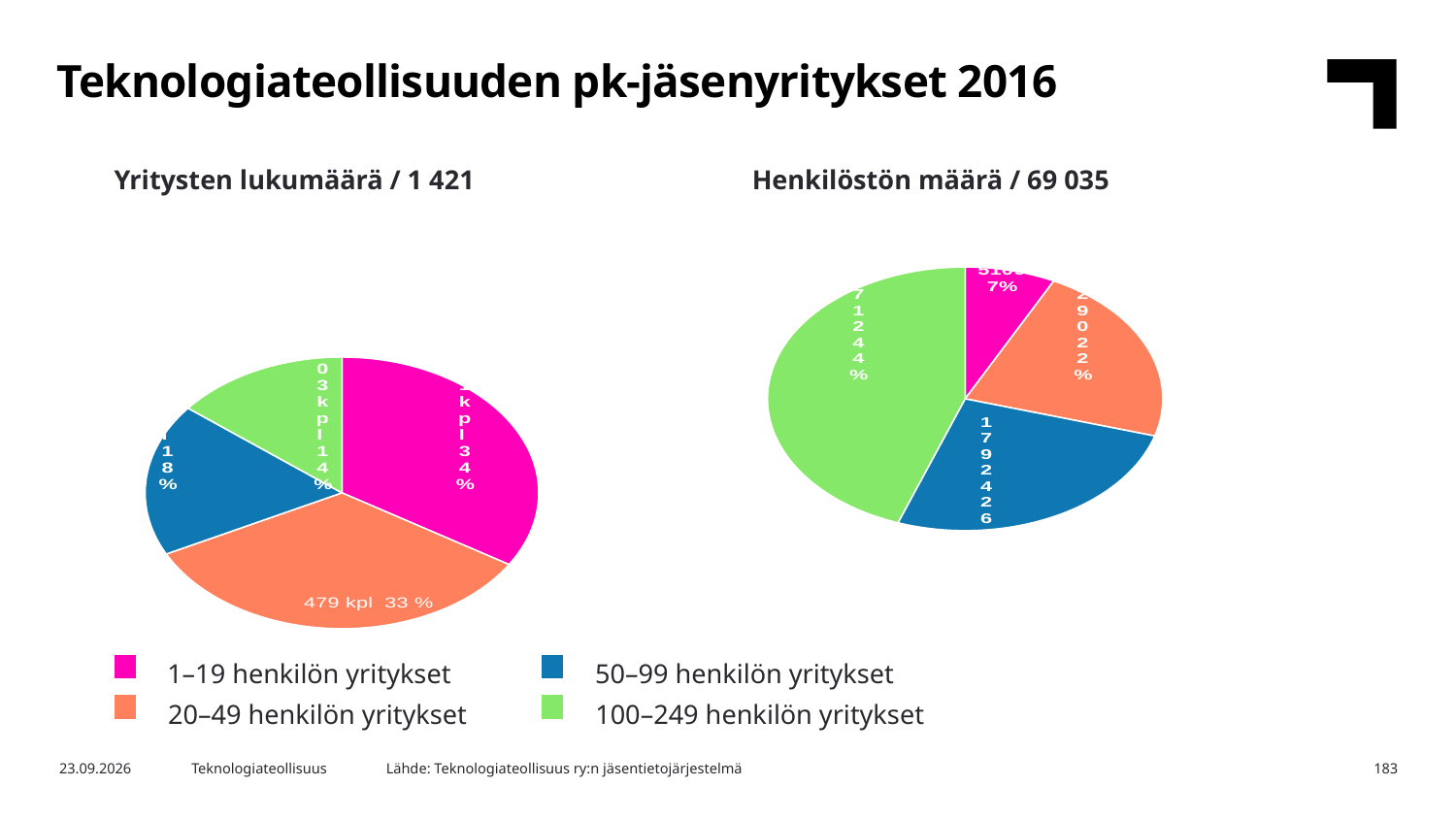
In the Yritysten lukumäärä pie chart, what share do the 20–49 henkilön yritykset have? 33 % In the Yritysten lukumäärä pie chart, what is the difference in percentage points between the 20–49 and 50–99 henkilön yritykset slices? 15 percentage points In the Henkilöstön määrä pie chart, which category has the largest slice? 100–249 henkilön yritykset What kind of chart is used on the left side of the slide (Yritysten lukumäärä)? Pie chart In the Yritysten lukumäärä pie chart, what share do the 100–249 henkilön yritykset have? 14 % In the Yritysten lukumäärä pie chart, what share do the 50–99 henkilön yritykset have? 18 % How many slices does the Henkilöstön määrä pie chart have? 4 In the Yritysten lukumäärä pie chart, how many companies (kpl) are in the 20–49 henkilön yritykset slice? 479 kpl In the Yritysten lukumäärä pie chart, which category has the smallest slice? 100–249 henkilön yritykset What total number of personnel is given in the title of the right-hand pie chart? 69 035 How many categories does the legend list? 4